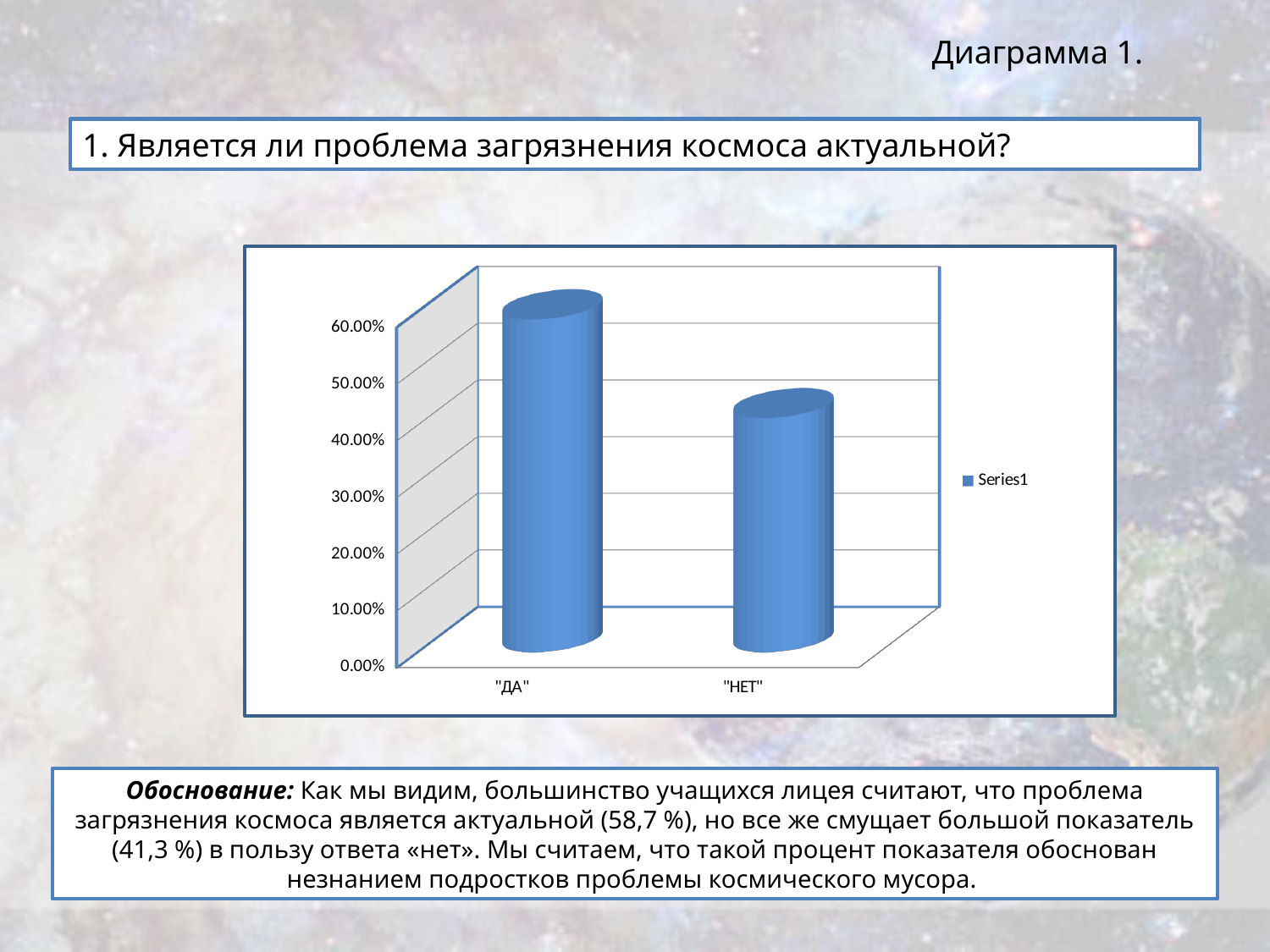
Which category has the highest value in the chart? "ДА" What is the highest value labelled on the vertical axis of the chart? 60.00% Which is larger, the value for "ДА" or the value for "НЕТ"? "ДА" Which category has the lowest value in the chart? "НЕТ" Is the value for "НЕТ" greater or less than 50.00%? less Is the value for "ДА" greater or less than 50.00%? greater What entry is listed in the chart legend? Series1 Is the value for "НЕТ" greater or less than 30.00%? greater How many series does the chart legend list? 1 What kind of chart is shown on the slide? bar chart How many categories are shown on the x axis of the chart? 2 Do the values rise or fall from "ДА" to "НЕТ" along the x axis? fall